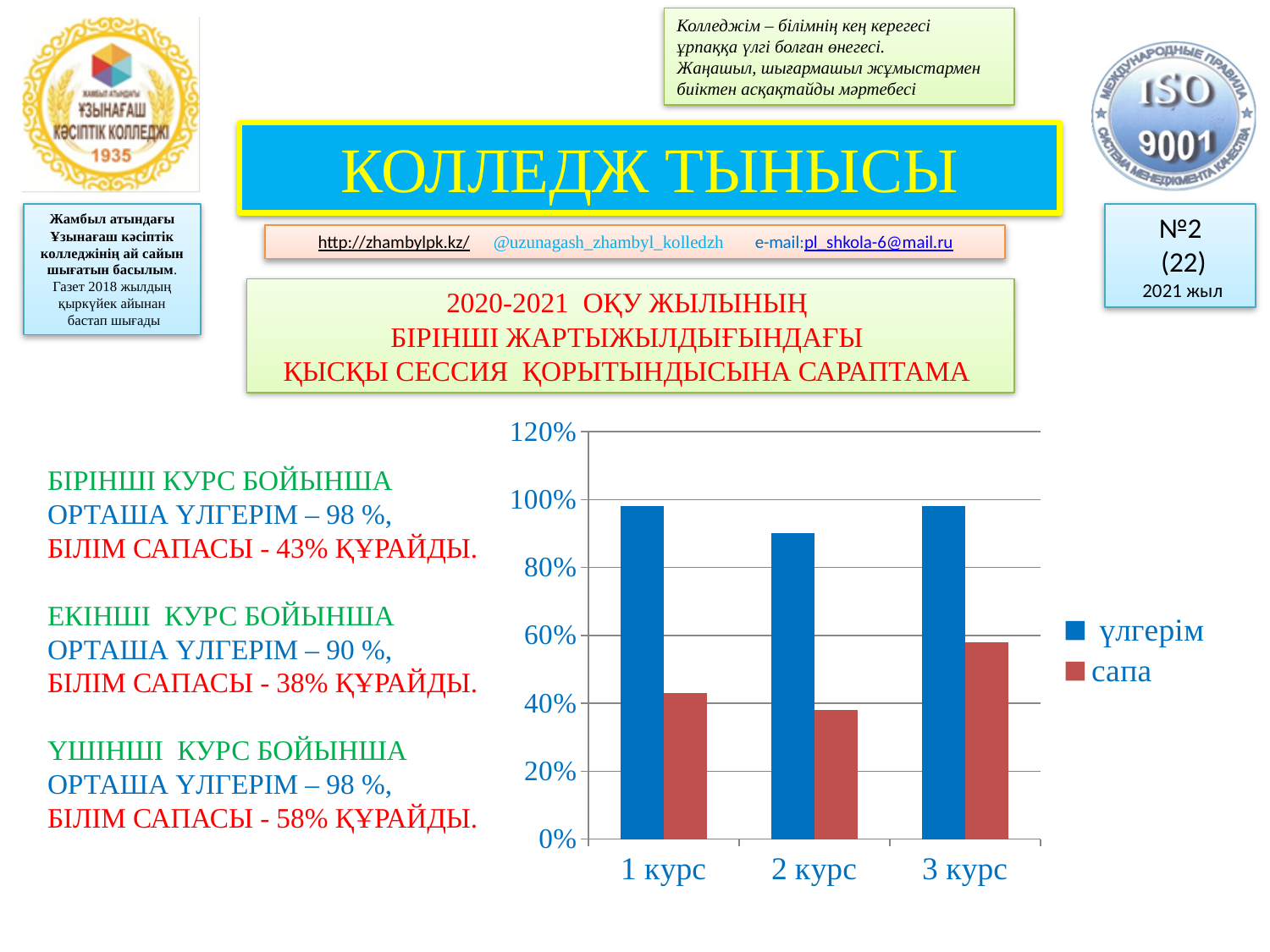
What kind of chart is shown on the slide? bar chart Which category has the lowest үлгерім value? 2 курс Is the сапа value for 2 курс greater or less than 40%? less Which series is shown in blue in the chart legend? үлгерім For 1 курс, which is larger: үлгерім or сапа? үлгерім How many series does the chart legend list? 2 Which category has the highest сапа value? 3 курс Is the сапа value for 3 курс greater or less than 40%? greater Is the сапа value for 1 курс greater or less than 60%? less Which category has the lowest сапа value? 2 курс How many categories are shown on the x axis of the chart? 3